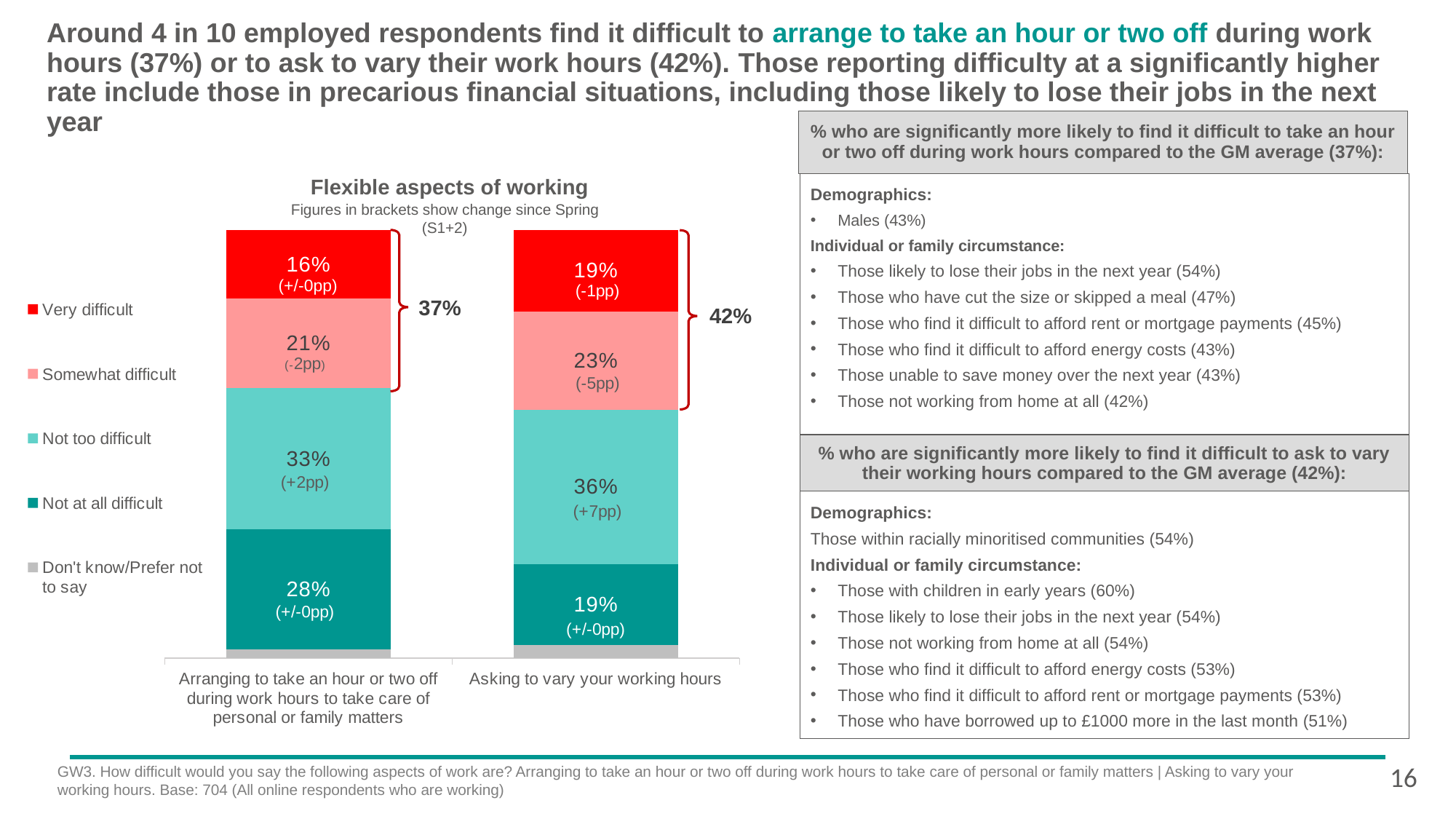
What percentage of respondents find it 'Not too difficult' to ask to vary their working hours? 36% What percentage of respondents find it 'Not at all difficult' to arrange to take an hour or two off during work hours? 28% What percentage of respondents find it 'Very difficult' to arrange to take an hour or two off during work hours? 16% Which category has the larger 'Very difficult' share: 'Arranging to take an hour or two off during work hours' or 'Asking to vary your working hours'? Asking to vary your working hours What is the difference between the 'Not at all difficult' values for 'Arranging to take an hour or two off' and 'Asking to vary your working hours'? 9 percentage points What type of chart is shown on the slide? Stacked bar chart Which response option has the highest share for 'Arranging to take an hour or two off during work hours'? Not too difficult How many categories are shown on the x axis of the 'Flexible aspects of working' chart? 2 What percentage of respondents find it 'Somewhat difficult' to ask to vary their working hours? 23% What is the combined share of 'Very difficult' and 'Somewhat difficult' for 'Asking to vary your working hours', as shown by the bracket? 42% What change since Spring is shown in brackets for the 'Not too difficult' segment of 'Asking to vary your working hours'? +7pp How many series does the legend of the 'Flexible aspects of working' chart list? 5